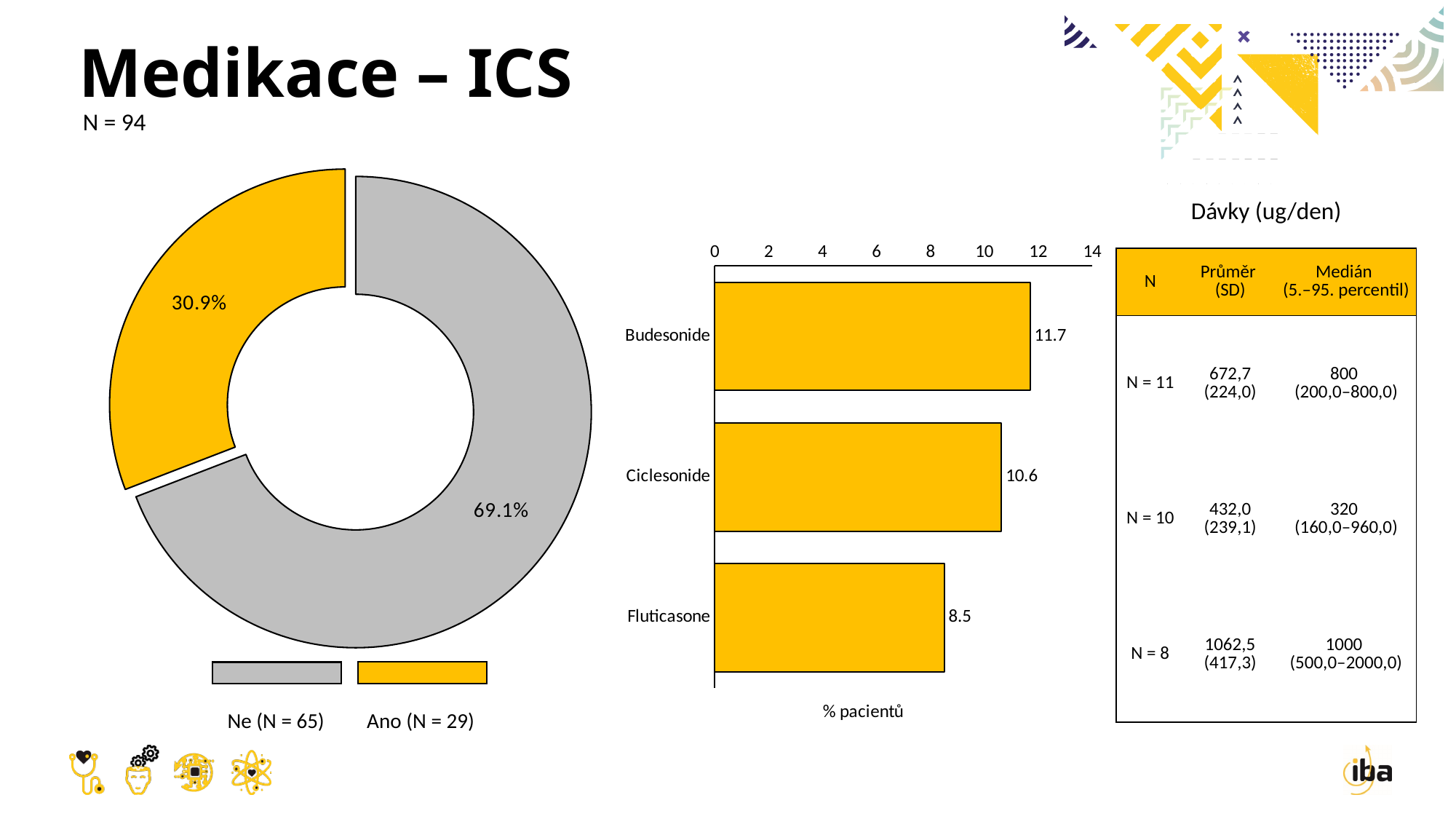
What kind of chart is the chart in the middle of the slide? bar chart In the donut chart on the left, what share is shown for Ano (N = 29)? 30.9% In the donut chart on the left, what share is shown for Ne (N = 65)? 69.1% In the bar chart, what is the value for Fluticasone? 8.5 In the bar chart, which category has the lowest value? Fluticasone In the donut chart on the left, which slice is larger, Ne or Ano? Ne In the bar chart, which is larger, the value for Ciclesonide or the value for Fluticasone? Ciclesonide In the bar chart, what is the value for Budesonide? 11.7 In the bar chart, what is the difference between the values for Budesonide and Ciclesonide? 1.1 What is the x-axis label of the bar chart? % pacientů In the bar chart, which category has the highest value? Budesonide In the bar chart, how many categories are shown? 3